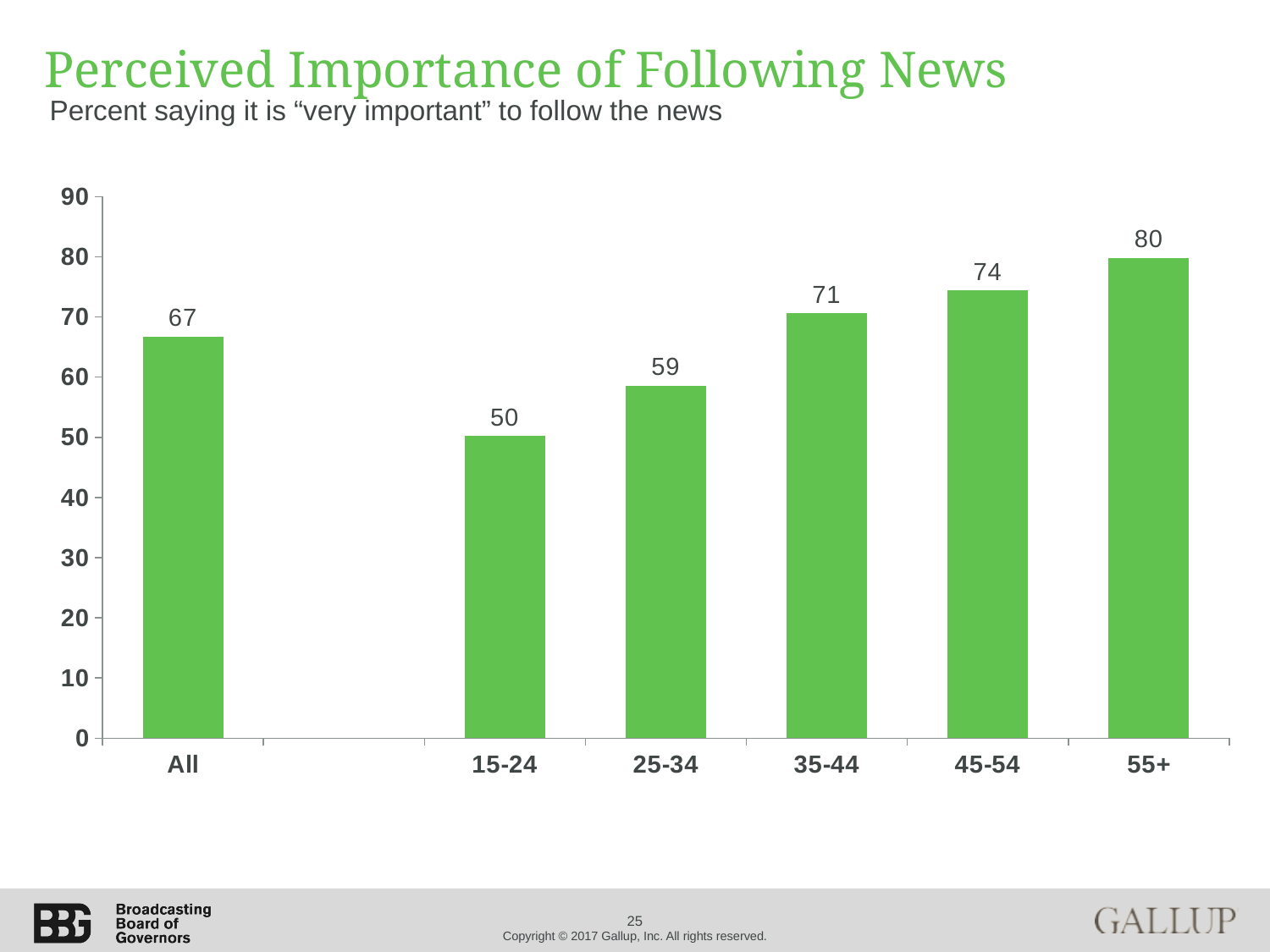
What is the value for the 15-24 age group? 50 Do the values rise or fall across the age groups from 15-24 to 55+? rise What is the difference between the values for 55+ and 15-24? 30 What kind of chart is shown on the slide? bar chart Is the value for 45-54 greater or less than 70? greater Which category has the lowest value? 15-24 What is the difference between the values for 45-54 and 25-34? 15 What is the value for the 35-44 age group? 71 What is the value for the All category? 67 Which category has the highest value? 55+ How many categories are shown on the x axis? 6 Which is larger, the value for 25-34 or the value for All? All